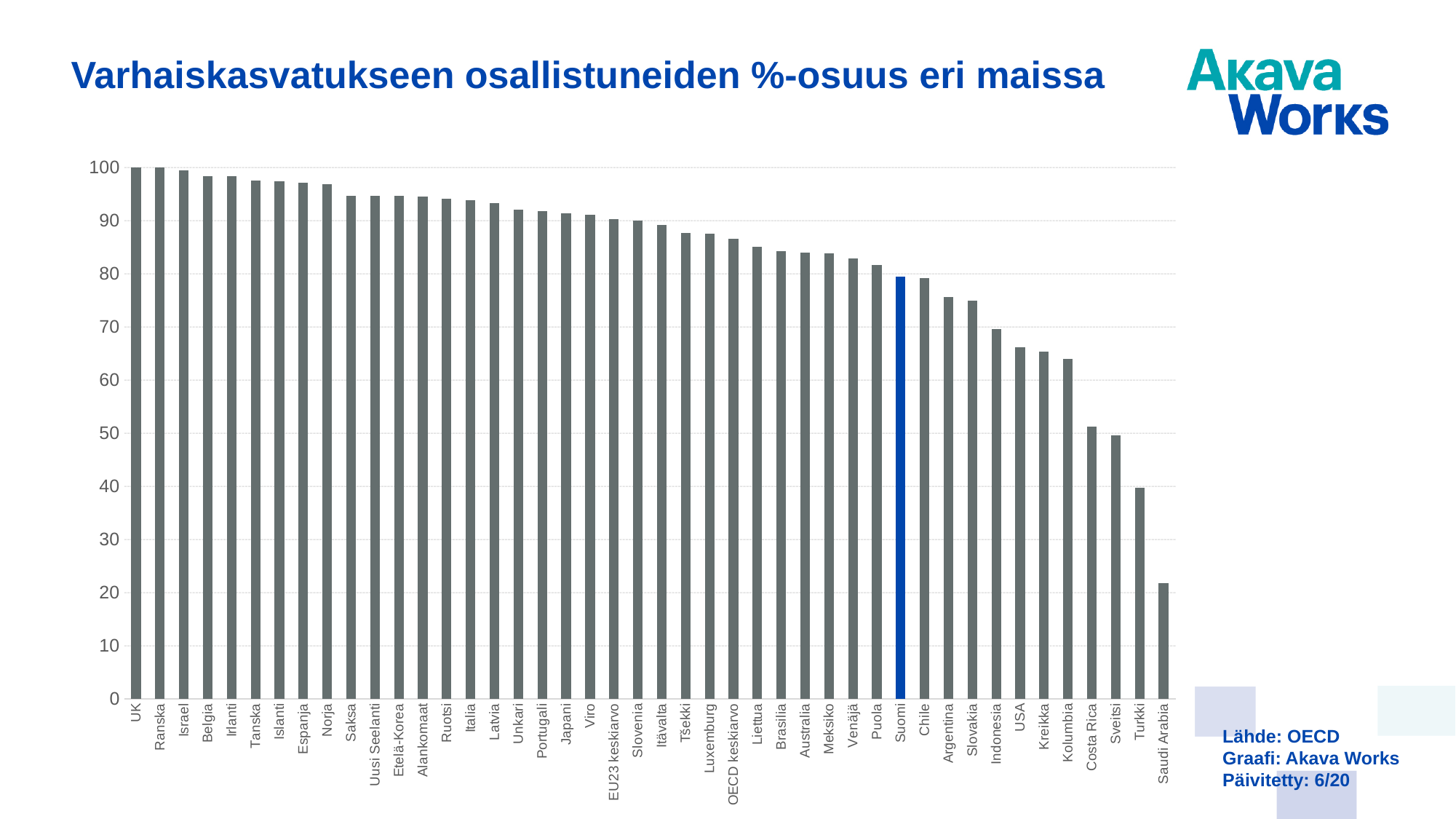
Which has the larger value, Suomi or USA? Suomi What is the title of the chart? Varhaiskasvatukseen osallistuneiden %-osuus eri maissa Is the value for Turkki greater or less than 50? less Which country has the lowest value in the chart? Saudi Arabia Is the value for Slovakia greater or less than 70? greater Do the values rise or fall from left to right along the x axis? fall How many countries or groups are shown as bars in the chart? 44 Is the value for Saudi Arabia greater or less than 20? greater Which country's bar is highlighted in blue? Suomi What kind of chart is shown on the slide? bar chart